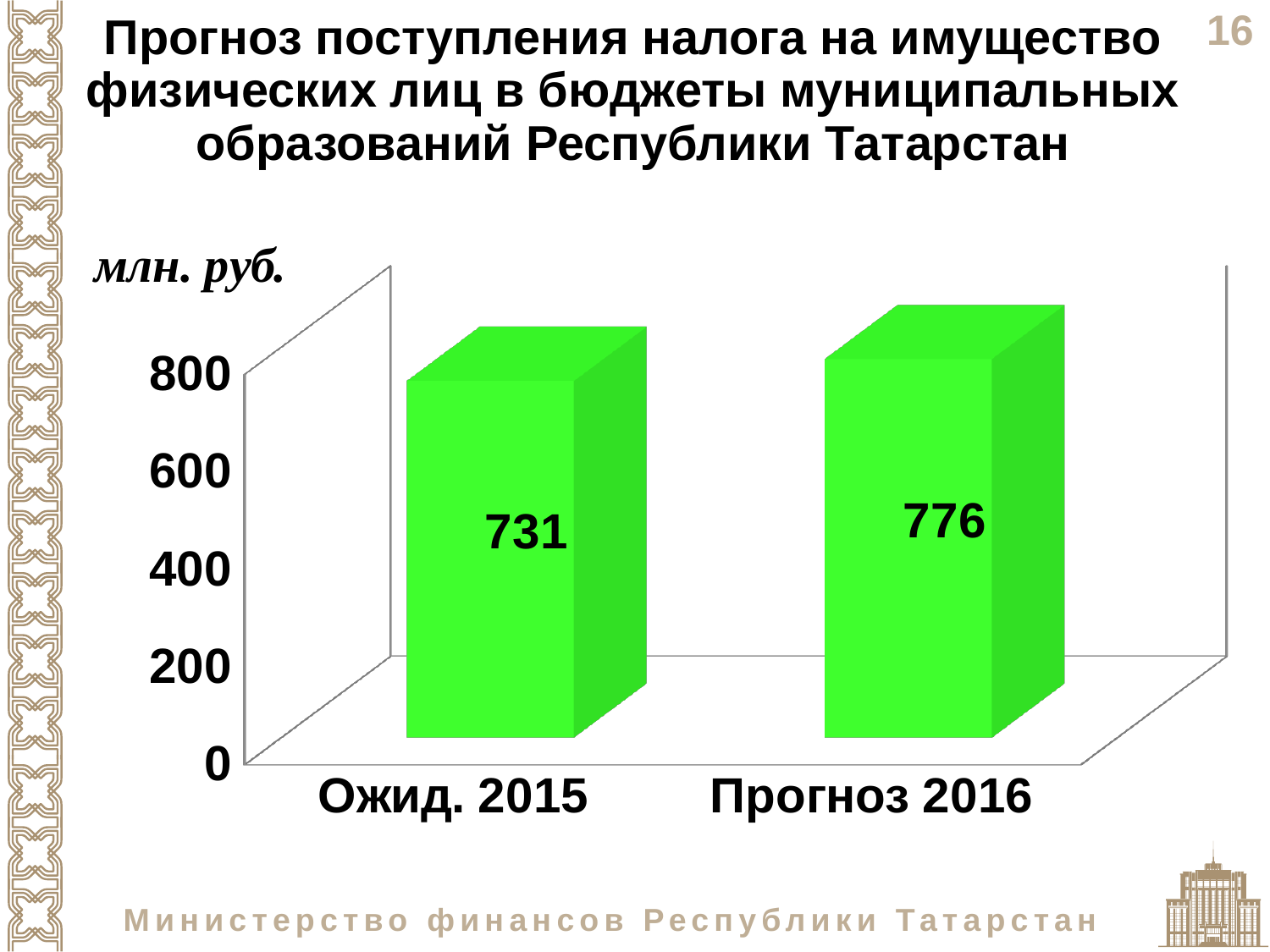
What colour are the bars in the chart? green What is the value for Ожид. 2015? 731 What is the difference between the values for Прогноз 2016 and Ожид. 2015? 45 Which category has the highest value? Прогноз 2016 Is the value for Ожид. 2015 greater or less than 600? greater What unit is shown for the values on the chart? млн. руб. What is the value for Прогноз 2016? 776 Which is larger, the value for Ожид. 2015 or the value for Прогноз 2016? Прогноз 2016 What kind of chart is shown on the slide? bar chart Do the values rise or fall from Ожид. 2015 to Прогноз 2016? rise How many categories are shown on the x axis? 2 Which category has the lowest value? Ожид. 2015